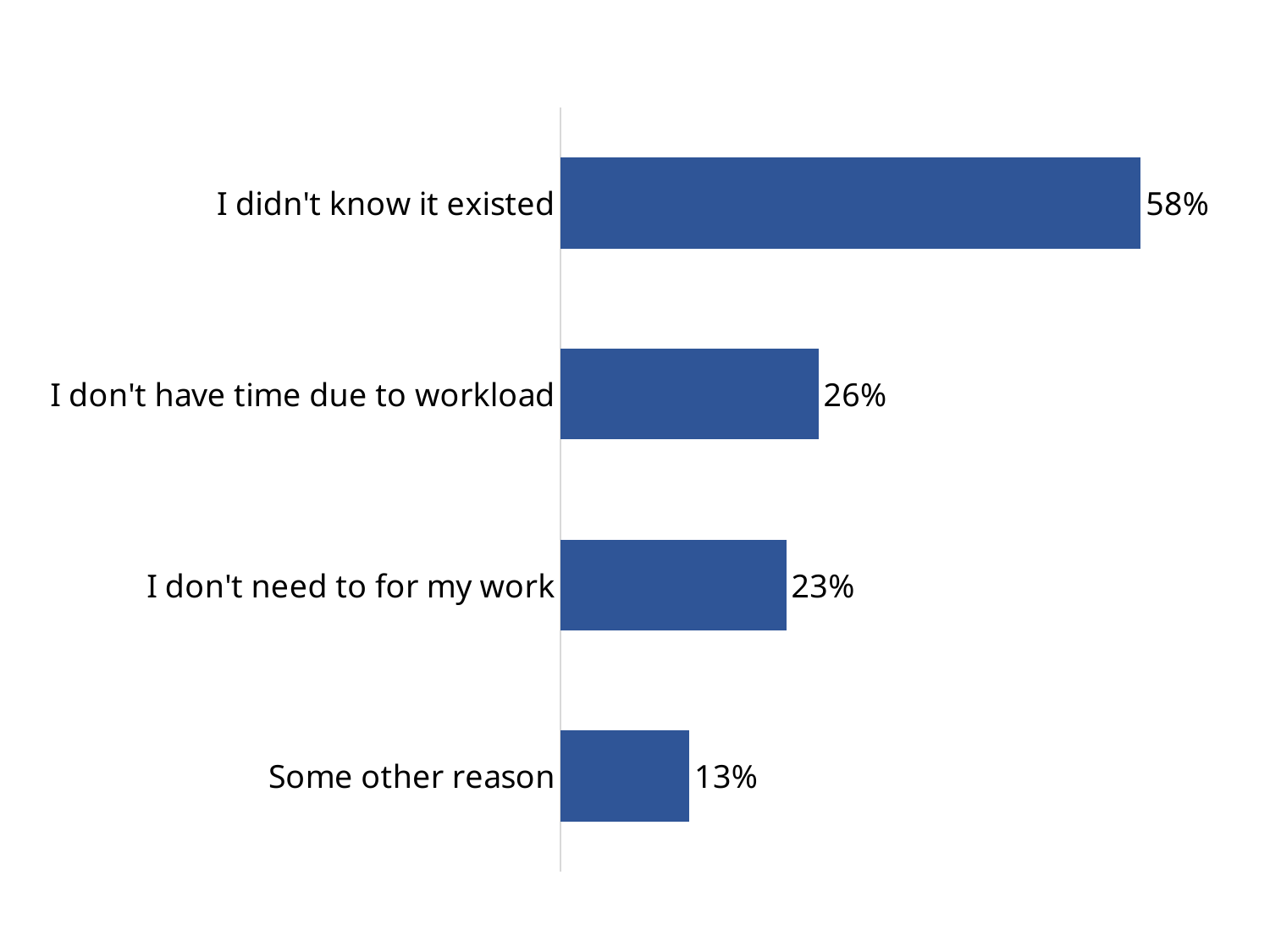
What is the value for "I don't have time due to workload"? 26% What is the value for "Some other reason"? 13% What kind of chart is this? Bar chart Which category has the highest value? I didn't know it existed Which category has the lowest value? Some other reason What is the difference between "I didn't know it existed" and "I don't have time due to workload"? 32% Which is larger: "I don't have time due to workload" or "I don't need to for my work"? I don't have time due to workload What colour are the bars in the chart? Blue What is the value for "I didn't know it existed"? 58% What is the difference between "I don't need to for my work" and "Some other reason"? 10% What is the value for "I don't need to for my work"? 23% How many categories are shown in the chart? 4